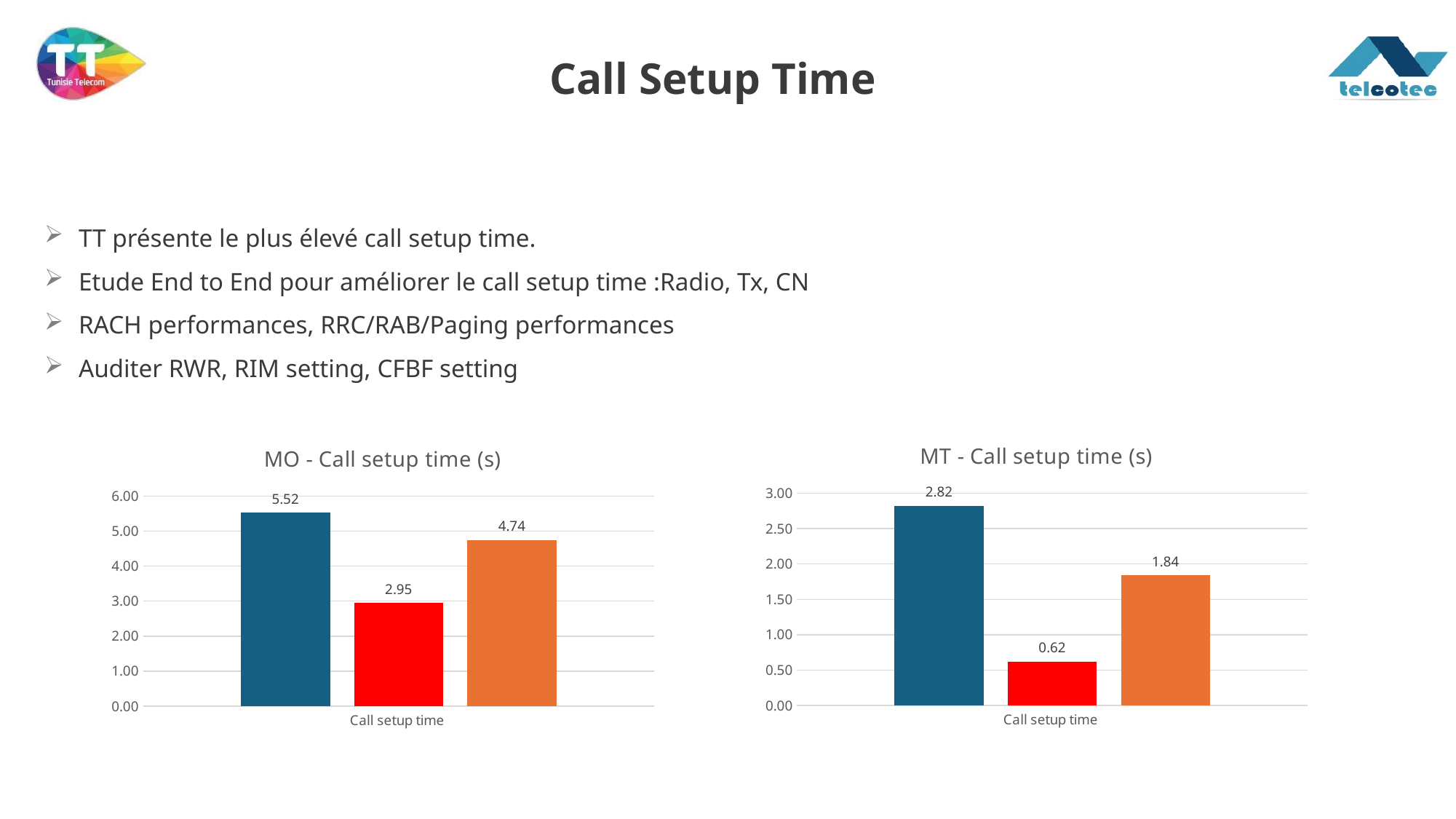
In the MT - Call setup time (s) chart, is the orange bar larger or smaller than the dark blue bar? smaller In the MT - Call setup time (s) chart, what is the value of the orange bar? 1.84 In the MT - Call setup time (s) chart, what is the value of the dark blue bar? 2.82 In the MO - Call setup time (s) chart, what is the difference between the dark blue bar and the red bar? 2.57 In the MO - Call setup time (s) chart, what is the value of the red bar? 2.95 In the MO - Call setup time (s) chart, what is the value of the orange bar? 4.74 What type of chart is the MO - Call setup time (s) chart? bar chart How many bars are plotted in the MT - Call setup time (s) chart? 3 In the MT - Call setup time (s) chart, which colour bar has the lowest value? red In the MO - Call setup time (s) chart, what is the value of the dark blue bar? 5.52 In the MT - Call setup time (s) chart, what is the value of the red bar? 0.62 In the MO - Call setup time (s) chart, which colour bar has the highest value? dark blue